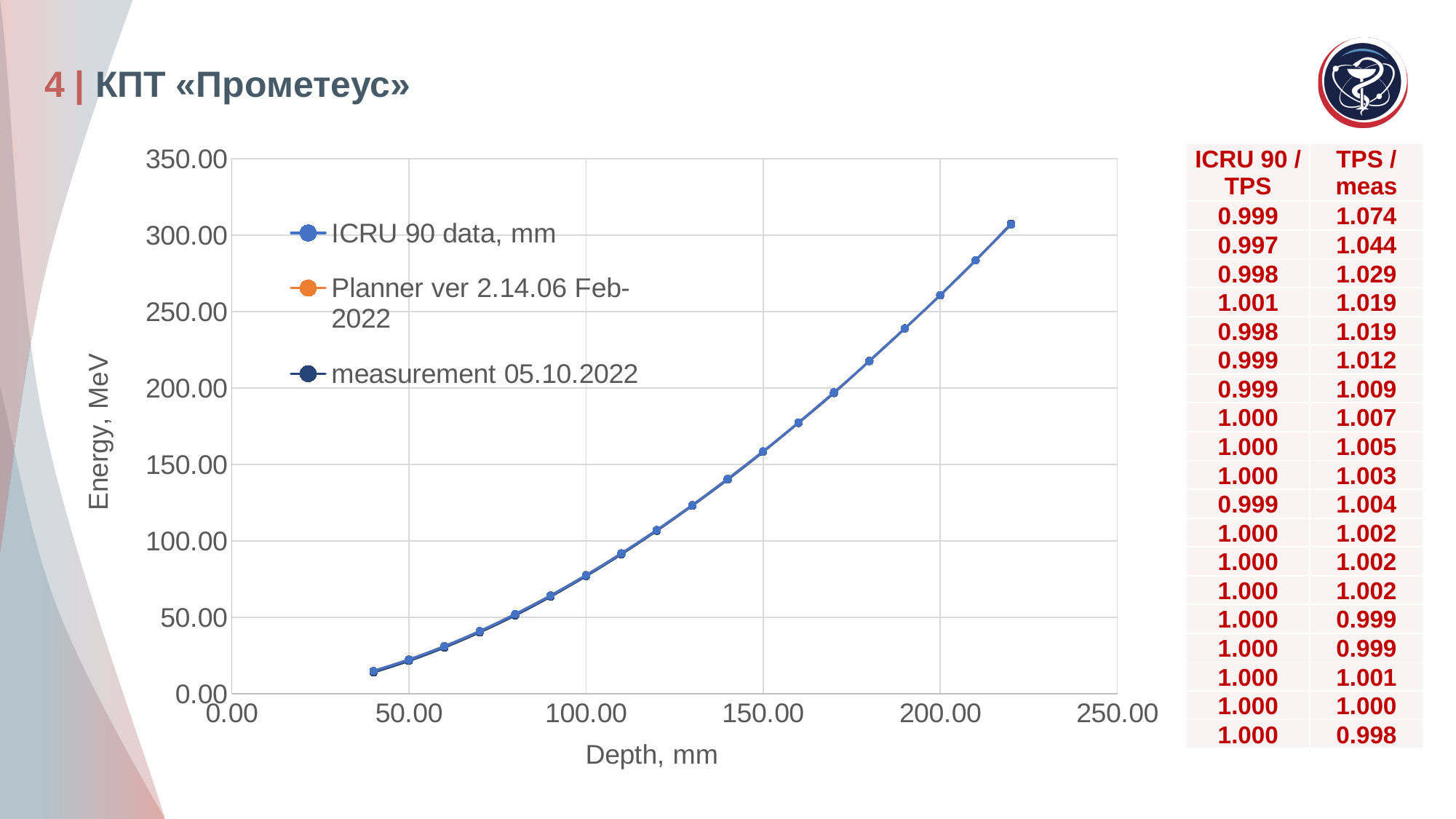
How many series does the chart legend list? 3 What is the name of the third series in the legend? measurement 05.10.2022 At which depth is the plotted energy highest? 220.00 mm What is the title of the y axis? Energy, MeV At which depth is the plotted energy lowest? 40.00 mm Do the energy values rise or fall as depth increases along the x axis? rise Is the energy value at a depth of 100.00 mm greater or less than 100? less Is the energy value at a depth of 200.00 mm greater or less than 250? greater How many data points are plotted along the curve? 19 Is the energy value at a depth of 50.00 mm greater or less than 50? less What kind of chart is shown on the slide? line chart